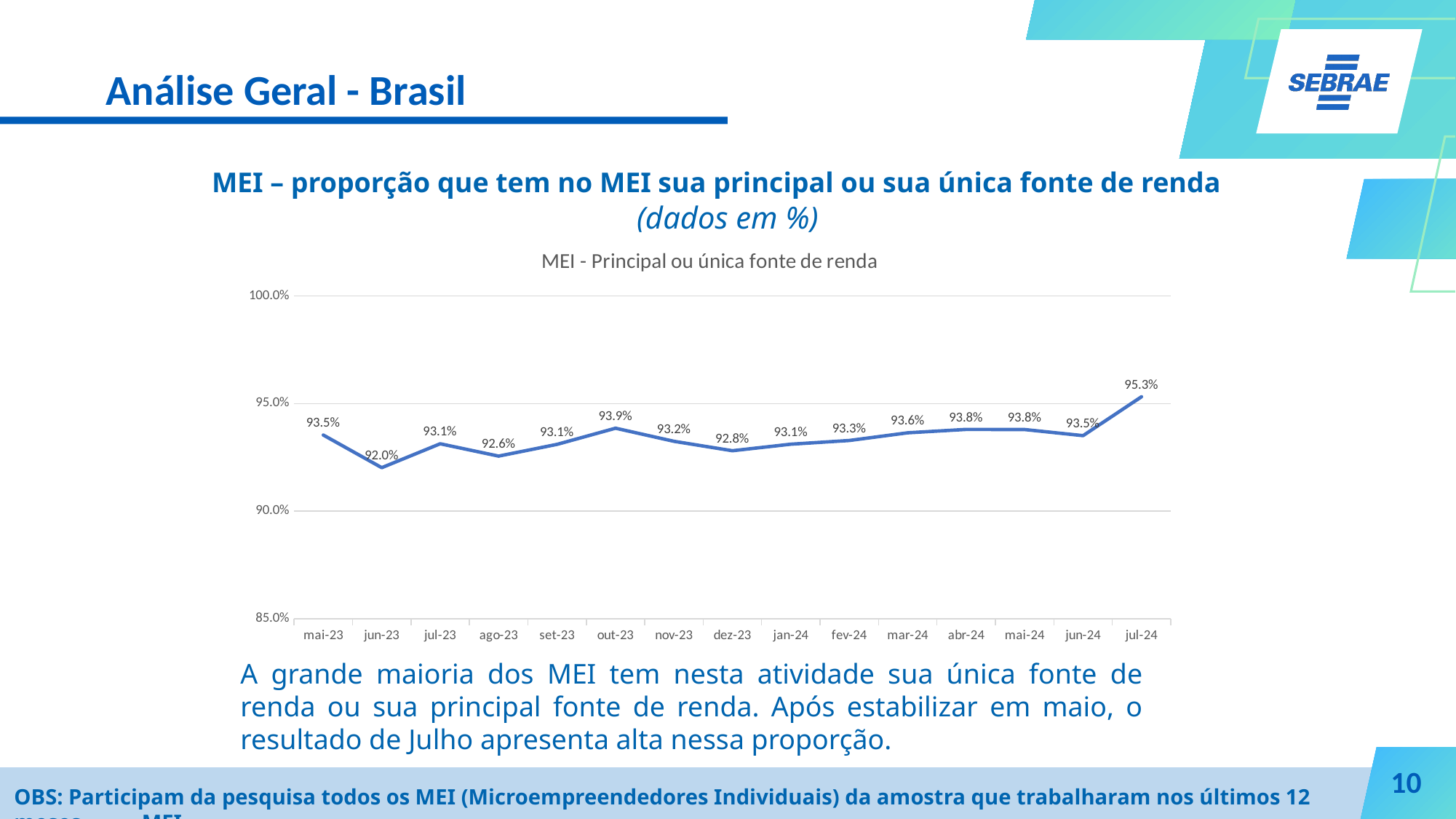
What is the title of the chart? MEI - Principal ou única fonte de renda Which month has the lowest value? jun-23 What type of chart is shown on the slide? Line chart What is the value for jun-23? 92.0% Which is larger, the value for ago-23 or the value for dez-23? dez-23 What is the difference between the values for mai-23 and jun-23? 1.5% What is the value for out-23? 93.9% Is the value for jul-24 greater or less than 95.0%? greater What is the difference between the values for jul-24 and jun-24? 1.8% Which month has the highest value? jul-24 How many months are plotted on the chart? 15 What is the value for jul-24? 95.3%